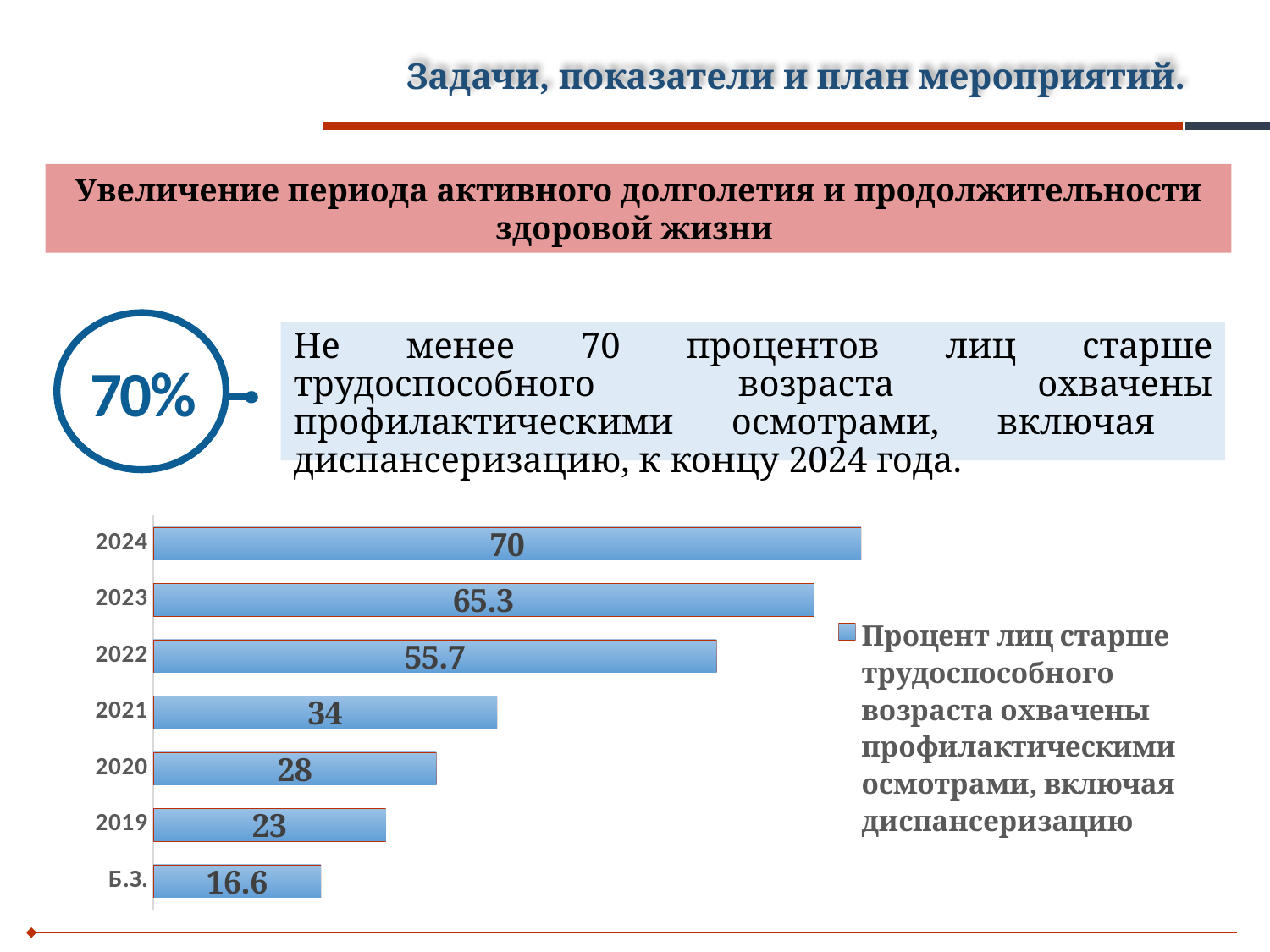
Which is larger, the value for 2022 or the value for 2021? 2022 What is the difference between the values for 2021 and 2019? 11 What is the value for 2022? 55.7 What is the difference between the values for 2024 and 2023? 4.7 What is the value for 2024? 70 Which category has the lowest value? Б.З. Which category has the highest value? 2024 What is the value for Б.З.? 16.6 What is the value for 2020? 28 How many categories are shown in the chart? 7 How many series does the legend list? 1 What kind of chart is shown on the slide? bar chart